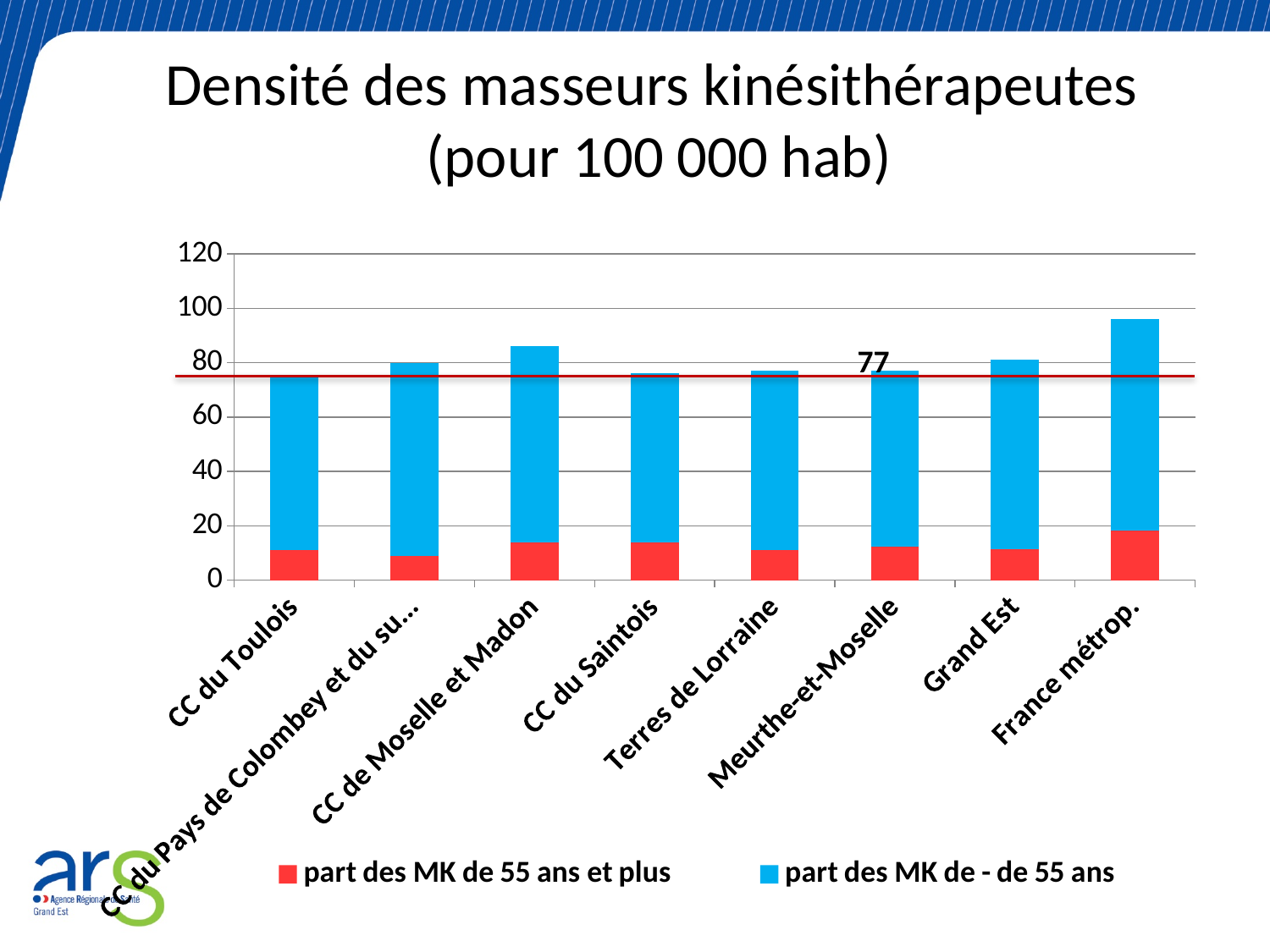
Which has the larger 'part des MK de 55 ans et plus' segment, France métrop. or CC du Pays de Colombey et du su...? France métrop. Is the total value for CC du Toulois greater or less than 80? less Which category has the highest total bar? France métrop. What kind of chart is shown on the slide? stacked bar chart Is the total value for CC du Saintois greater or less than 100? less Is the total value for France métrop. greater or less than 80? greater How many series does the legend list? 2 Which colour represents 'part des MK de - de 55 ans' in the legend? blue How many categories are plotted along the x axis? 8 Which has the larger total bar, CC de Moselle et Madon or CC du Saintois? CC de Moselle et Madon What is the title of the chart? Densité des masseurs kinésithérapeutes (pour 100 000 hab)